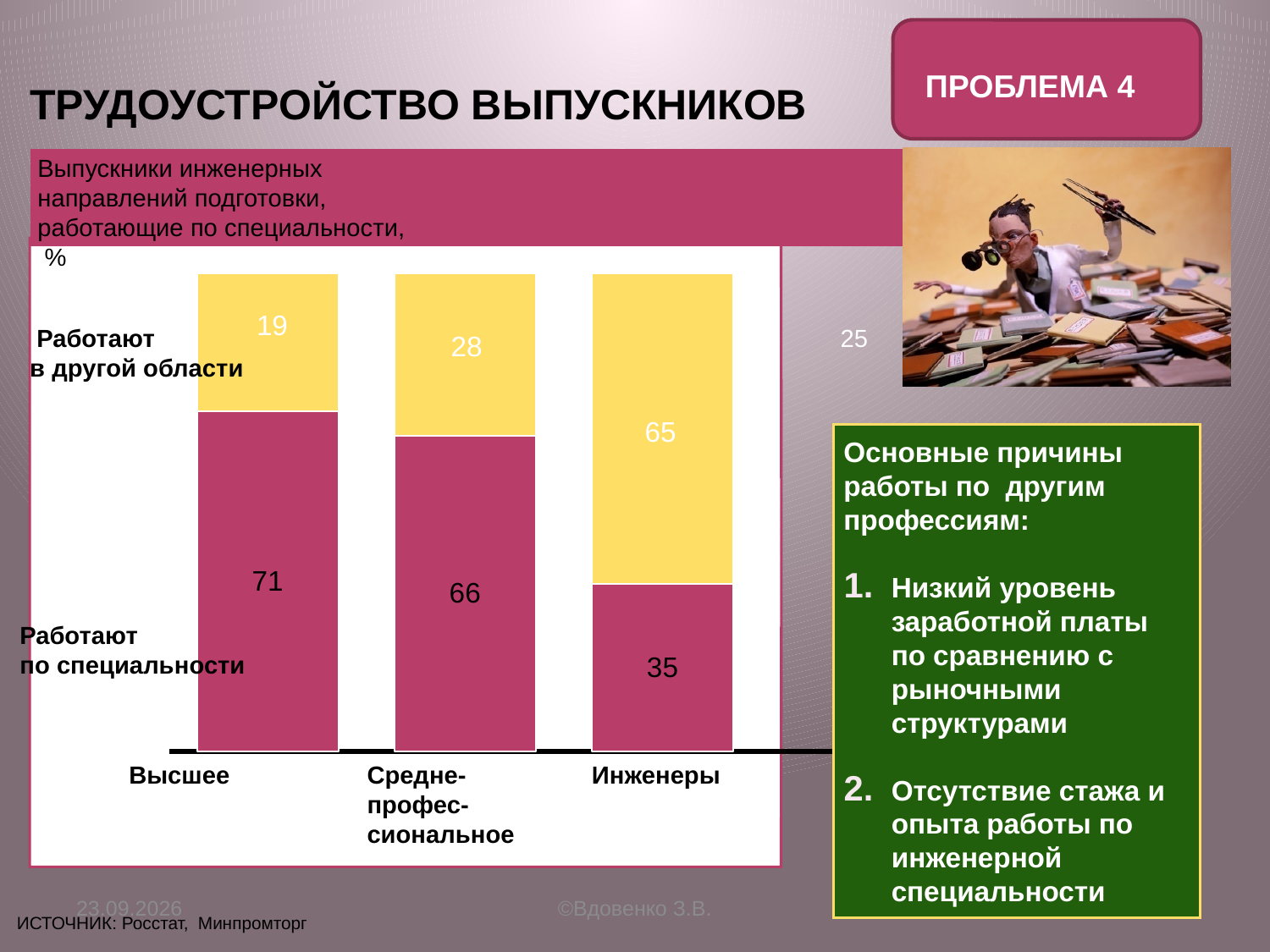
Which category has the highest value for 'Работают по специальности'? Высшее What is the total of the stacked bar for the 'Средне-профессиональное' category? 94 What is the value for 'Работают в другой области' for the 'Инженеры' category? 65 Which is larger for the 'Инженеры' category: 'Работают по специальности' or 'Работают в другой области'? Работают в другой области What is the value for 'Работают по специальности' for the 'Высшее' category? 71 Which colour represents 'Работают в другой области' in the chart? yellow Which category has the lowest value for 'Работают в другой области'? Высшее How many categories are shown on the x axis of the chart? 3 What is the value for 'Работают в другой области' for the 'Средне-профессиональное' category? 28 What is the value for 'Работают по специальности' for the 'Инженеры' category? 35 What kind of chart is shown on the slide? stacked bar chart What is the difference between the 'Работают по специальности' values for 'Высшее' and 'Инженеры'? 36